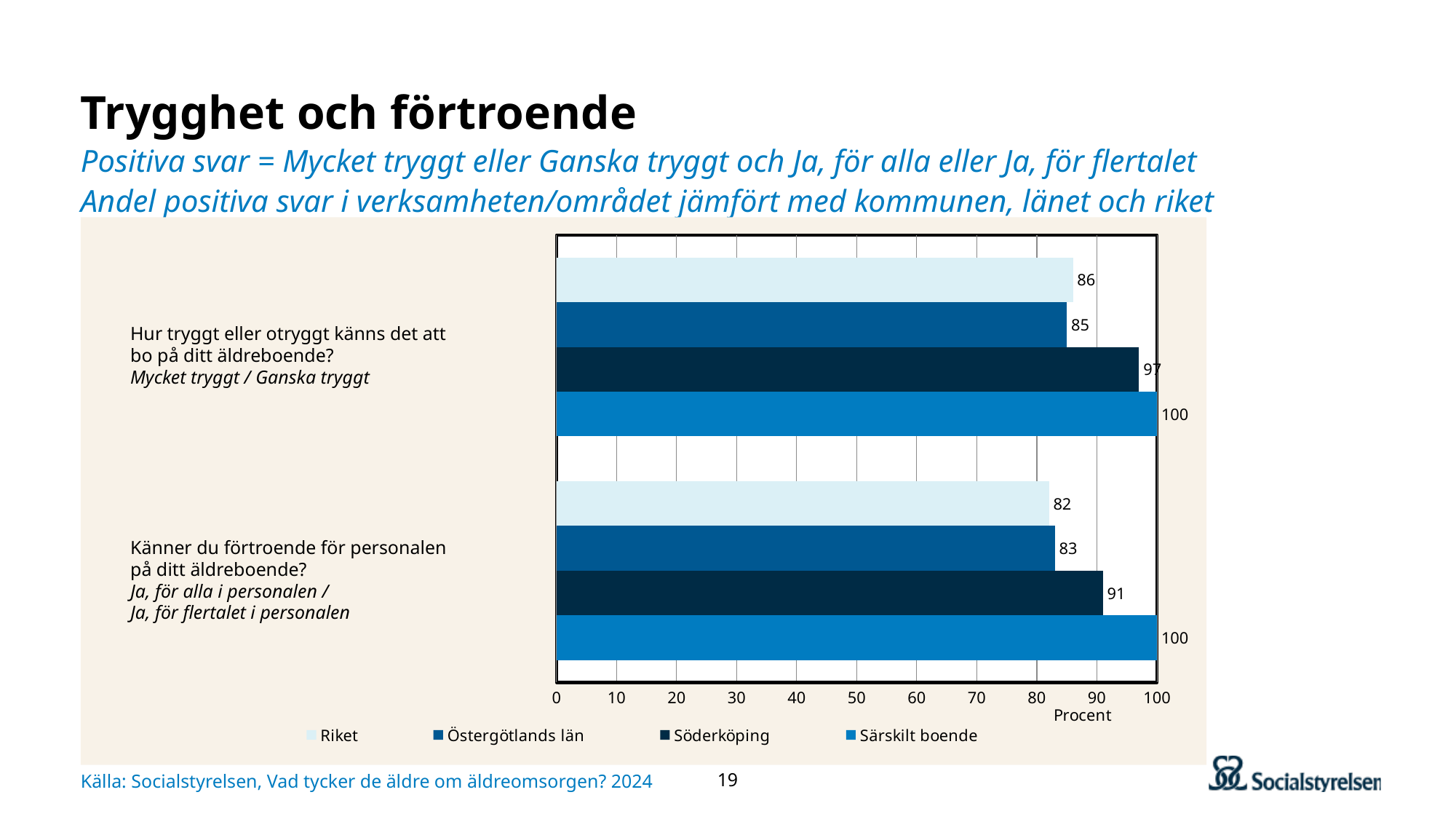
What is the value for Söderköping on the question "Hur tryggt eller otryggt känns det att bo på ditt äldreboende?"? 97 What kind of chart is shown on the slide? Bar chart What is the value for Särskilt boende on the question "Känner du förtroende för personalen på ditt äldreboende?"? 100 What is the difference between Särskilt boende and Söderköping on the question "Känner du förtroende för personalen på ditt äldreboende?"? 9 Which series has the lowest value on the question "Känner du förtroende för personalen på ditt äldreboende?"? Riket Which series has the highest value on the question "Känner du förtroende för personalen på ditt äldreboende?"? Särskilt boende What is the value for Riket on the question "Känner du förtroende för personalen på ditt äldreboende?"? 82 What is the value for Östergötlands län on the question "Hur tryggt eller otryggt känns det att bo på ditt äldreboende?"? 85 What is the difference between Söderköping and Riket on the question "Hur tryggt eller otryggt känns det att bo på ditt äldreboende?"? 11 What unit is shown on the x axis of the chart? Procent How many series does the legend list? 4 Which is larger on the question "Hur tryggt eller otryggt känns det att bo på ditt äldreboende?": Söderköping or Östergötlands län? Söderköping